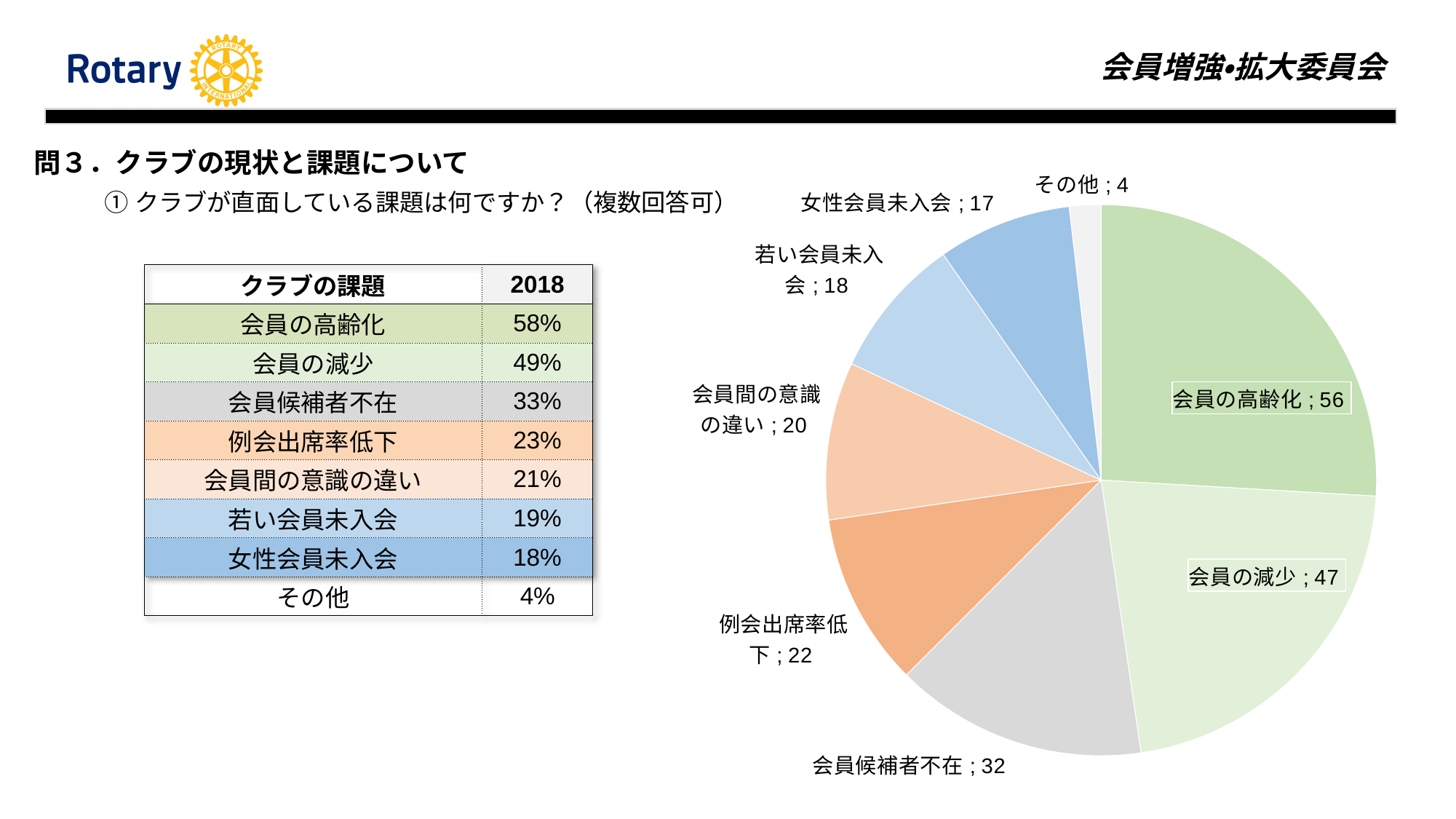
Which category has the largest slice in the pie chart? 会員の高齢化 In the pie chart, what is the value for 会員の高齢化? 56 In the pie chart, what is the value for 会員候補者不在? 32 How many slices does the pie chart have? 8 What is the difference between the values for 会員間の意識の違い and その他 in the pie chart? 16 In the pie chart, what is the value for 例会出席率低下? 22 In the pie chart, which is larger: 若い会員未入会 or 女性会員未入会? 若い会員未入会 What is the difference between the values for 会員の高齢化 and 会員の減少 in the pie chart? 9 Which category has the smallest slice in the pie chart? その他 In the pie chart, what is the value for 女性会員未入会? 17 What kind of chart is shown on the slide? pie chart In the pie chart, what is the value for 会員の減少? 47